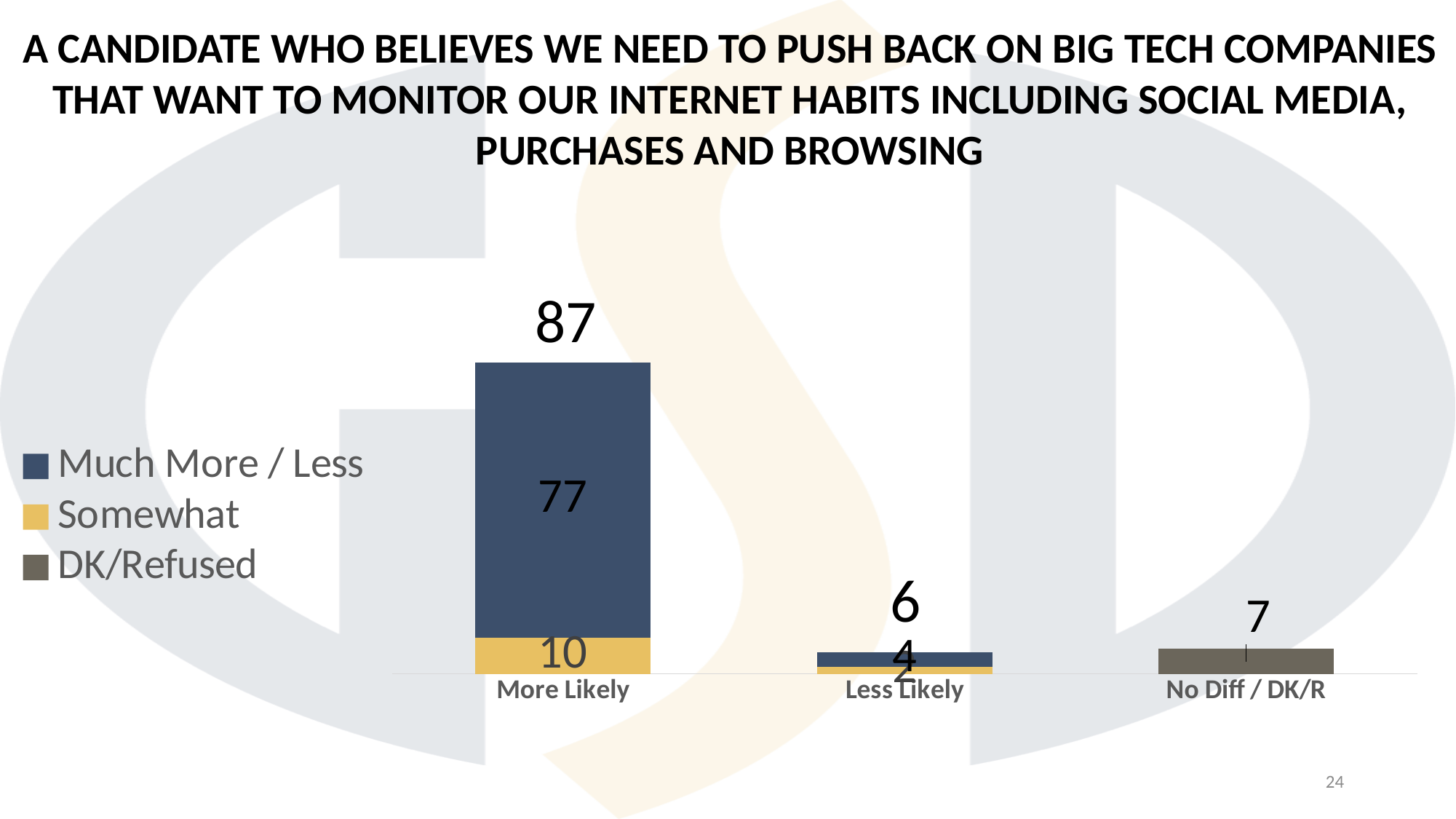
What is the difference between the More Likely total and the Less Likely total? 81 What is the total value shown above the Less Likely bar? 6 Which category has the lowest total? Less Likely What is the value for the No Diff / DK/R category? 7 What is the Much More / Less value for the Less Likely category? 4 Which is larger, the total for Less Likely or the value for No Diff / DK/R? No Diff / DK/R How many series does the legend list? 3 What is the Somewhat value for the More Likely category? 10 Which category has the highest total? More Likely What is the total value shown above the More Likely bar? 87 How many categories are shown on the x axis? 3 What is the Much More / Less value for the More Likely category? 77